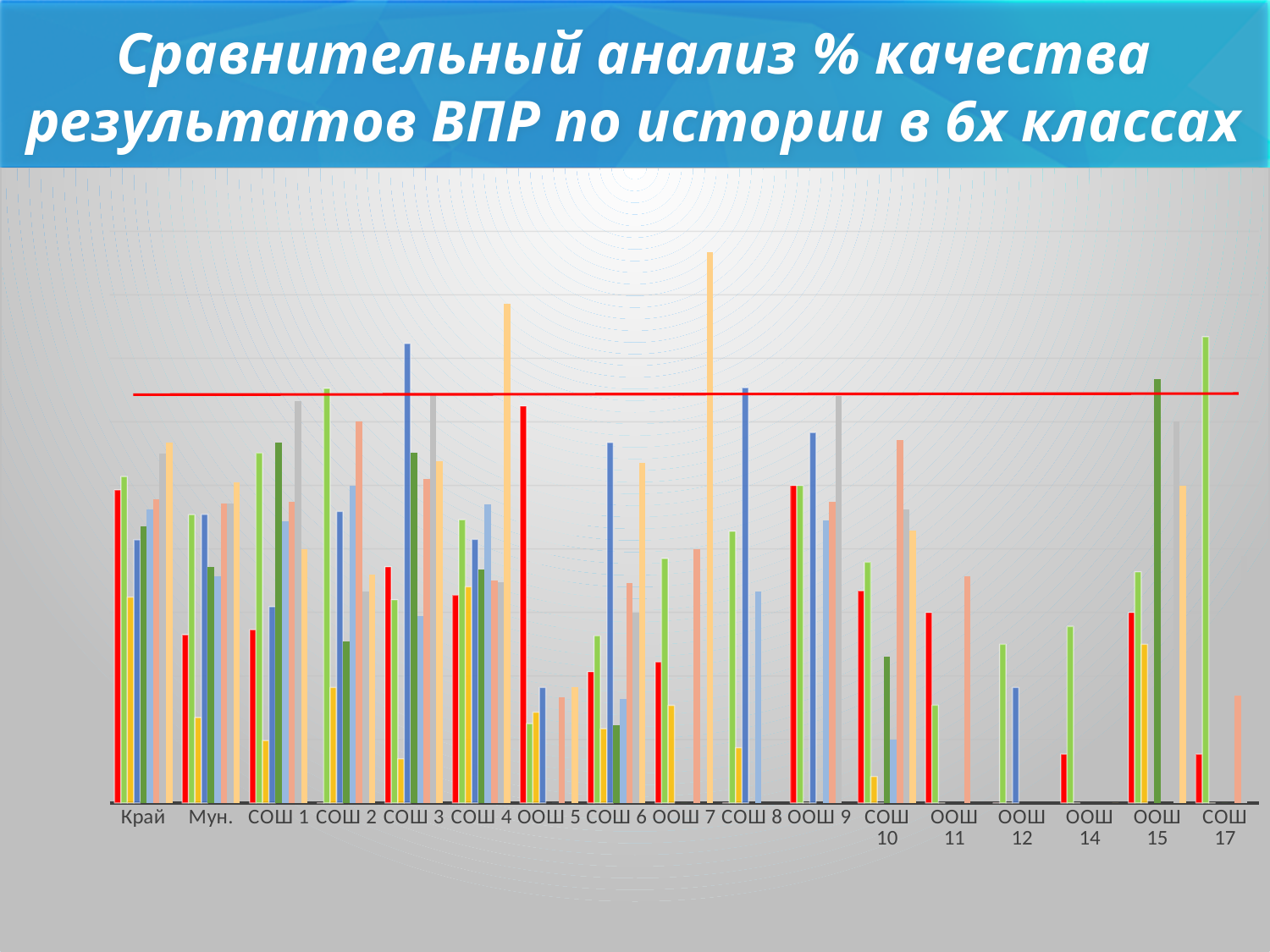
What colour is the horizontal reference line drawn across the chart? red Which category contains the single tallest bar in the chart? ООШ 7 What is the title of the slide containing the chart? Сравнительный анализ % качества результатов ВПР по истории в 6х классах Which category is listed last on the x axis of the chart? СОШ 17 Which category is listed first on the x axis of the chart? Край How many categories are shown along the x axis of the chart? 17 What kind of chart is shown on the slide? bar chart